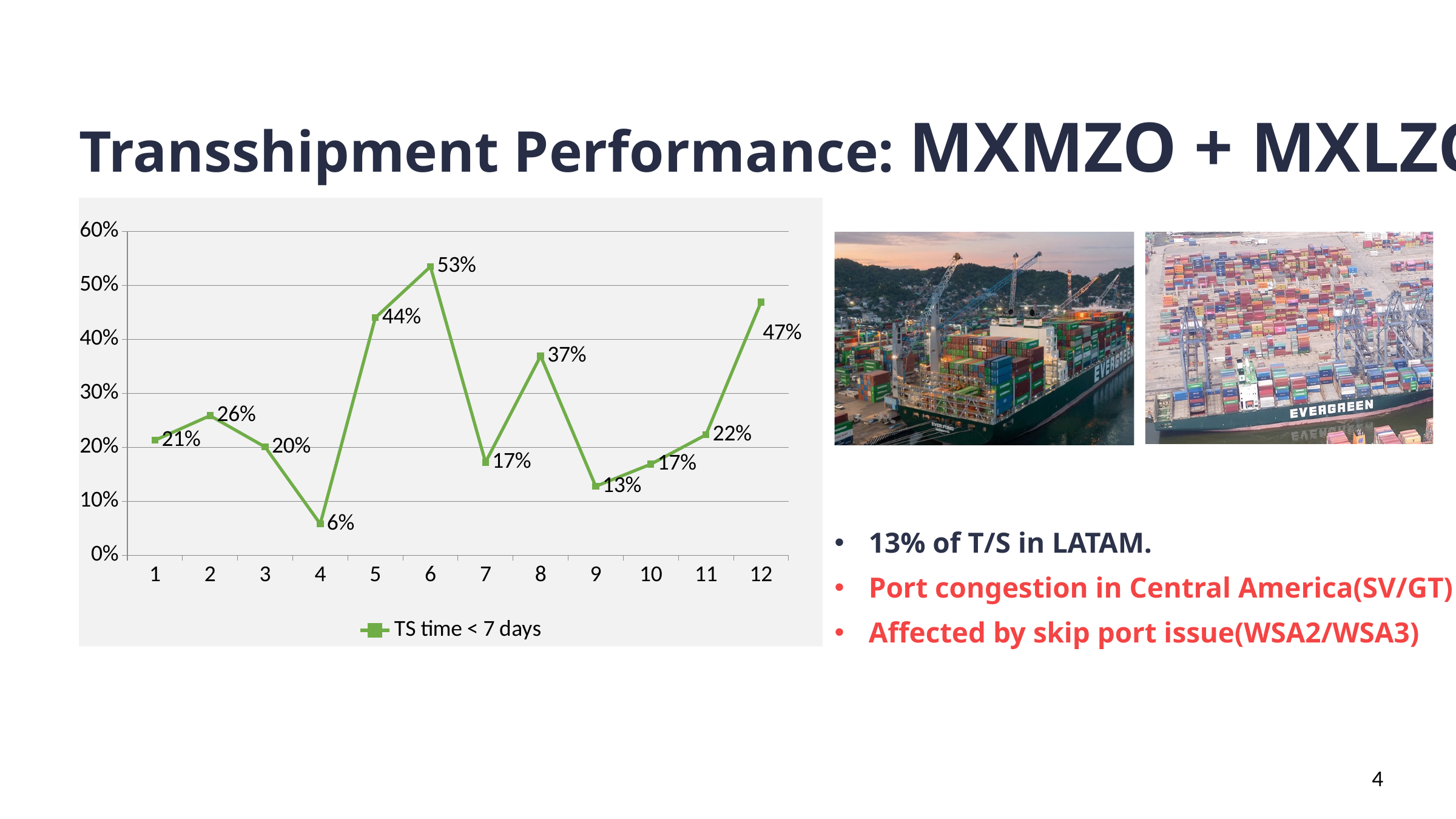
What is the difference between the values at point 12 and point 11? 25% Which is larger, the value at point 5 or the value at point 8? point 5 Is the value at point 9 greater or less than 20%? less What is the value of TS time < 7 days at point 12? 47% What is the value of TS time < 7 days at point 4? 6% What is the difference between the values at point 6 and point 4? 47% What is the value of TS time < 7 days at point 6? 53% Which point on the x axis has the lowest value for TS time < 7 days? 4 How many points are plotted on the x axis? 12 Which point on the x axis has the highest value for TS time < 7 days? 6 What series name does the legend show? TS time < 7 days What kind of chart is shown on the slide? line chart